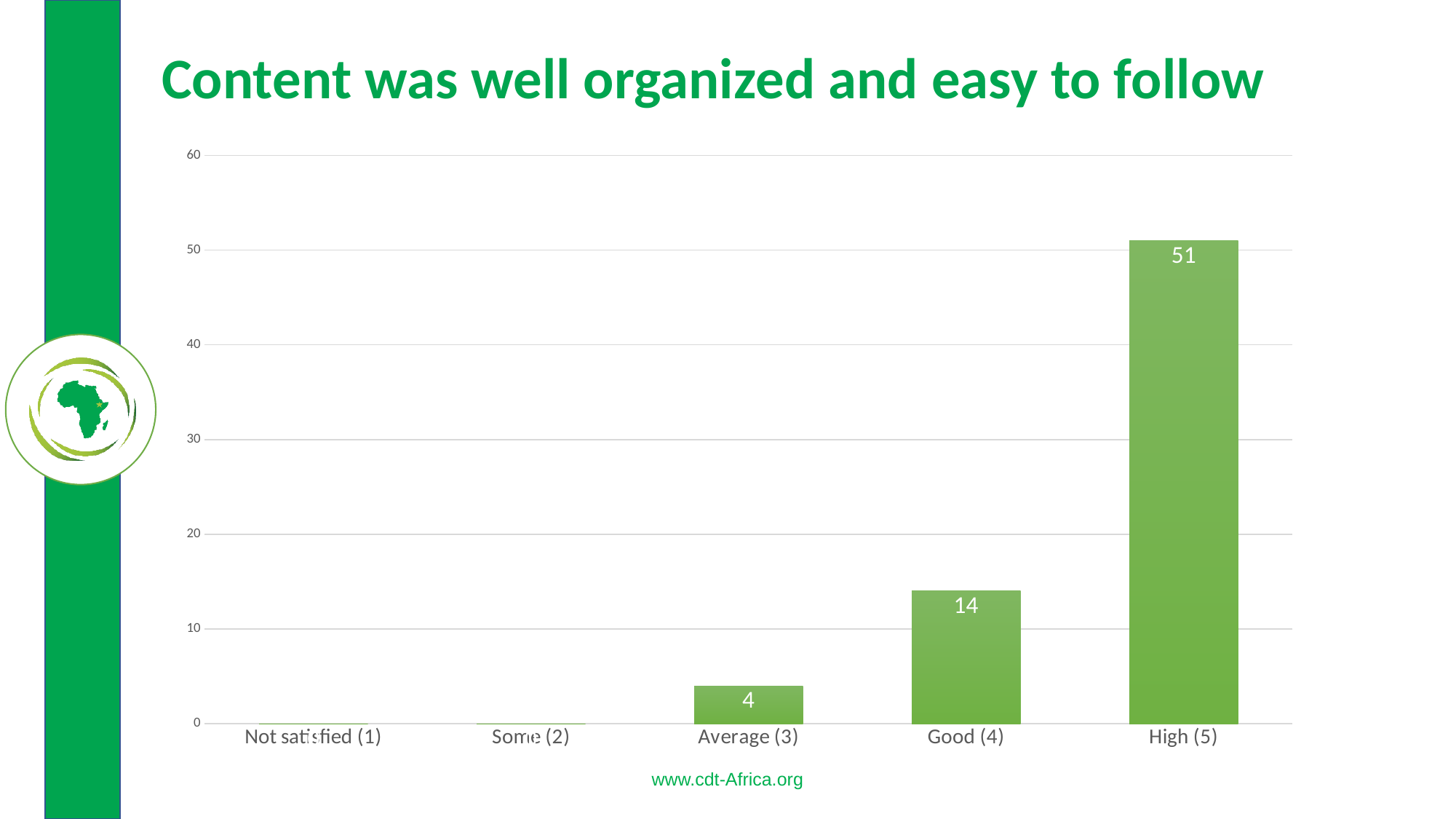
What is the difference between the values for High (5) and Good (4)? 37 What is the value for Good (4)? 14 What is the value for High (5)? 51 What kind of chart is shown on the slide? bar chart How many categories are shown on the x axis? 5 Is the value for Good (4) greater or less than 20? less Which category has the highest value? High (5) Do the values rise or fall from left to right along the x axis? rise What is the difference between the values for Good (4) and Average (3)? 10 Which is larger, the value for Good (4) or the value for Average (3)? Good (4) What is the value for Average (3)? 4 Is the value for Not satisfied (1) greater or less than 10? less